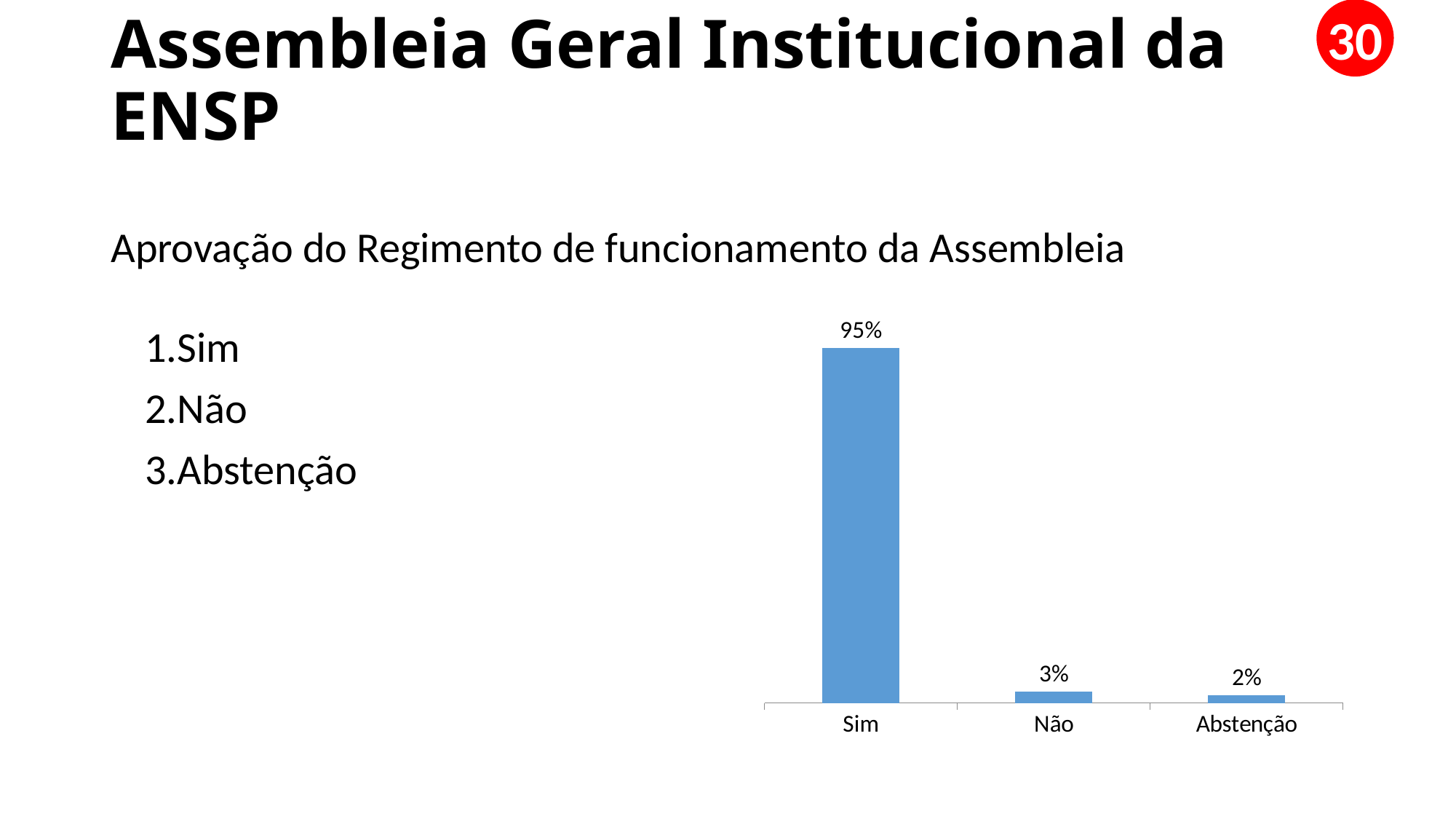
Which category has the highest value? Sim What kind of chart is shown on the slide? bar chart What is the value for Sim? 95% What is the value for Não? 3% Which category has the lowest value? Abstenção What is the value for Abstenção? 2% Do the values rise or fall from left to right along the x axis? fall What colour are the bars in the chart? blue What is the difference between the values for Não and Abstenção? 1% Which is larger, the value for Sim or the value for Abstenção? Sim How many categories are shown on the x axis? 3 What is the difference between the values for Sim and Não? 92%